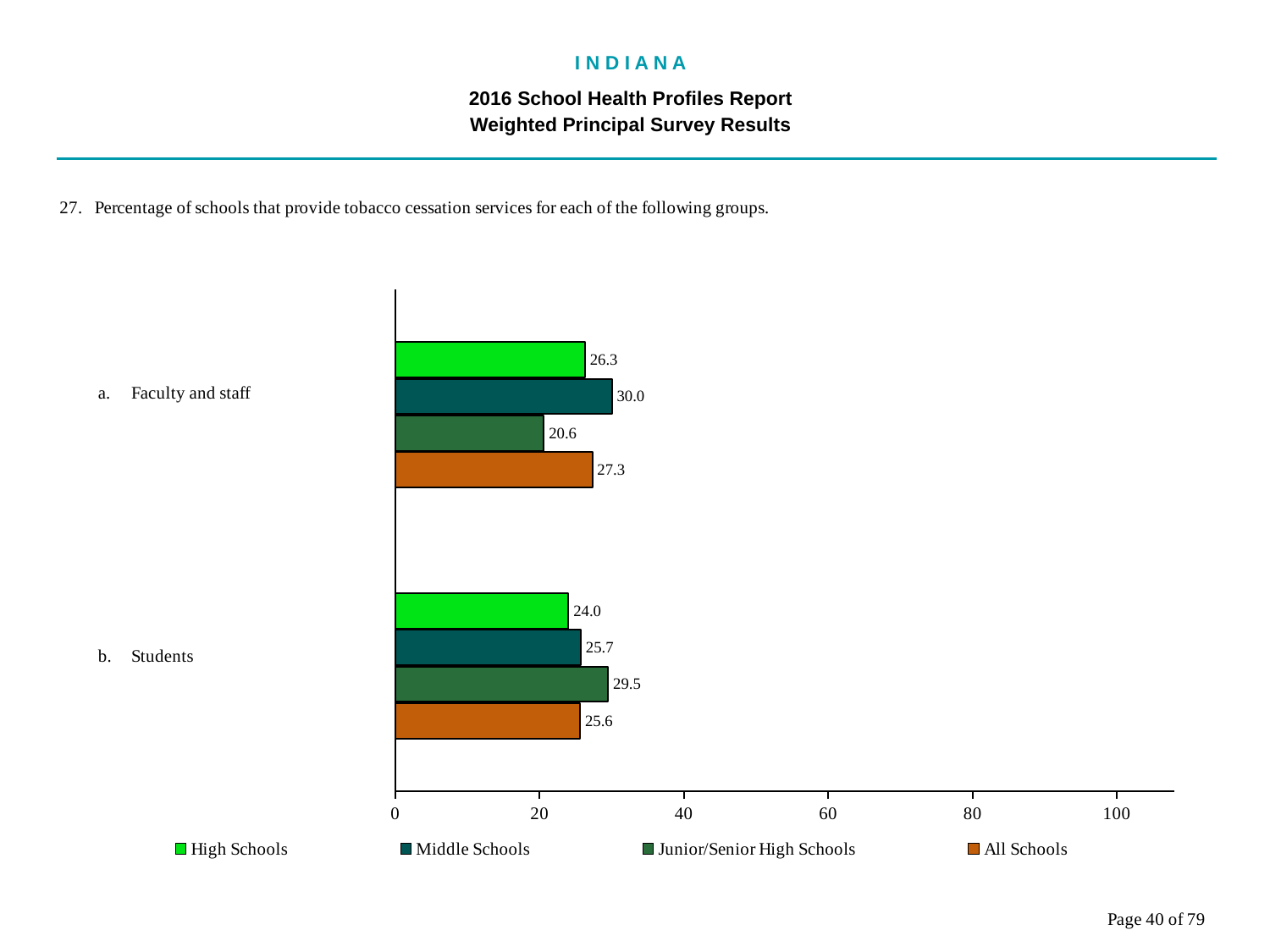
What is the difference between the Middle Schools value and the Junior/Senior High Schools value in the Faculty and staff category? 9.4 Which is larger: the High Schools value for Faculty and staff or the High Schools value for Students? Faculty and staff Which series has the highest value in the Students category? Junior/Senior High Schools Is the value for Middle Schools in the Students category greater or less than 40? less What is the value for All Schools in the Faculty and staff category? 27.3 What kind of chart is shown on the slide? bar chart What is the value for Middle Schools in the Faculty and staff category? 30.0 What colour represents All Schools in the legend? orange How many series does the legend list? 4 What is the value for Junior/Senior High Schools in the Students category? 29.5 What is the value for High Schools in the Students category? 24.0 Which series has the lowest value in the Faculty and staff category? Junior/Senior High Schools